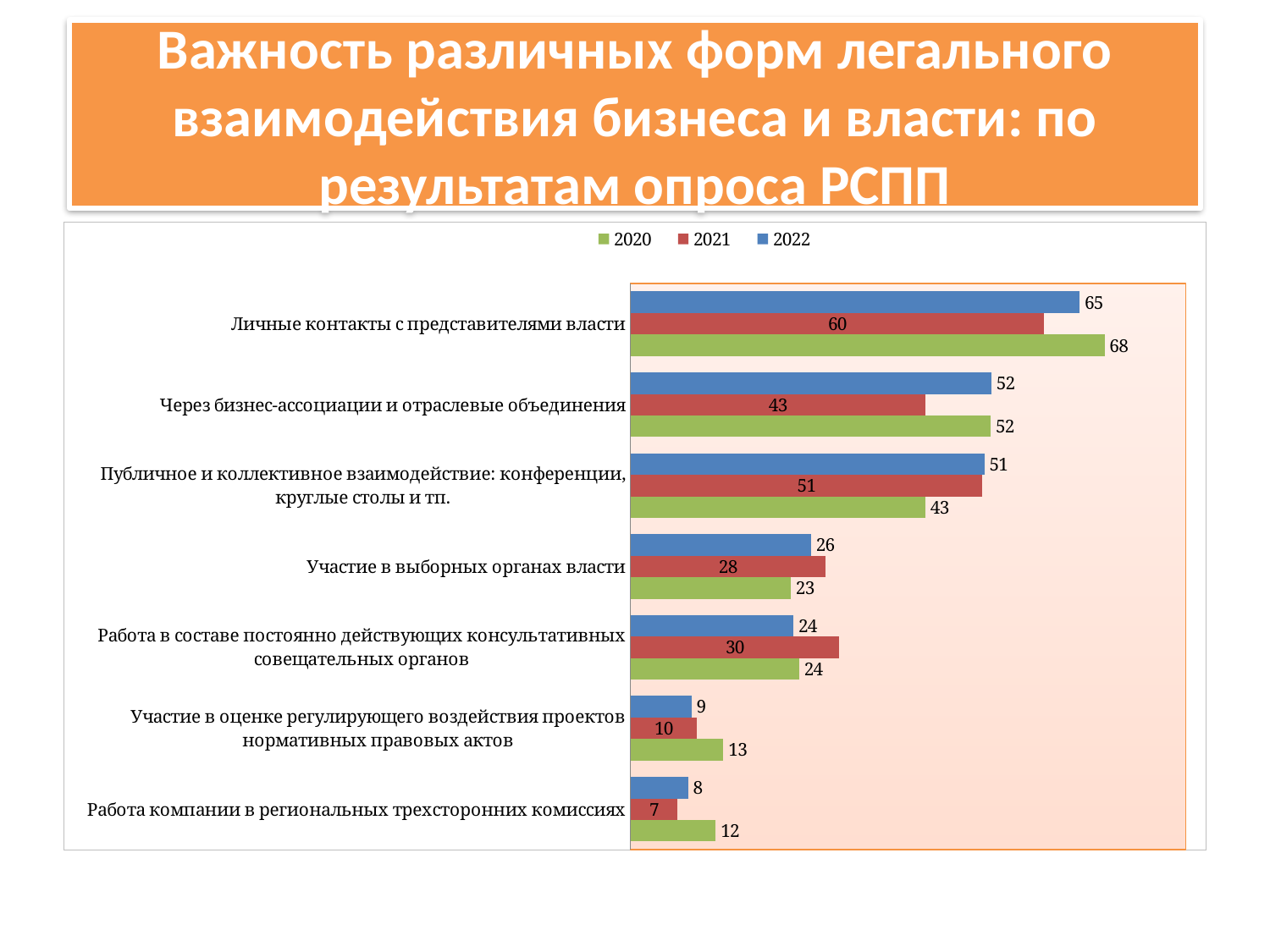
How many series does the legend list? 3 Which category has the highest 2020 value? Личные контакты с представителями власти Which category has the lowest 2021 value? Работа компании в региональных трехсторонних комиссиях What is the difference between the 2020 and 2021 values for 'Личные контакты с представителями власти'? 8 What type of chart is shown on the slide? bar chart Which colour represents the 2022 series in the chart? blue How many categories are shown in the chart? 7 What is the 2020 value for 'Работа компании в региональных трехсторонних комиссиях'? 12 What is the 2022 value for 'Личные контакты с представителями власти'? 65 For 'Работа в составе постоянно действующих консультативных совещательных органов', which is larger: the 2021 value or the 2022 value? 2021 What is the 2021 value for 'Через бизнес-ассоциации и отраслевые объединения'? 43 What is the difference between the 2022 and 2020 values for 'Публичное и коллективное взаимодействие: конференции, круглые столы и тп.'? 8